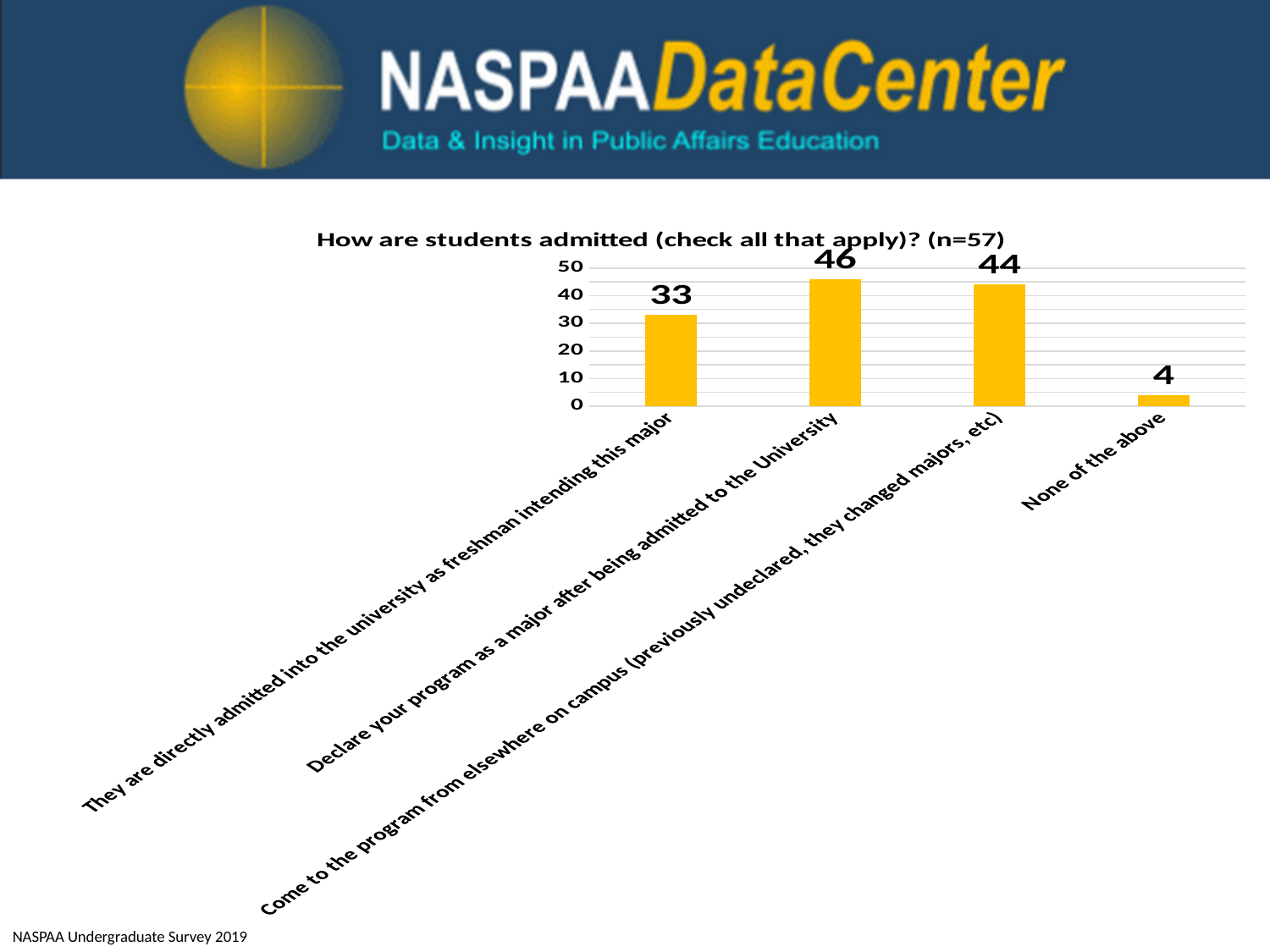
Which is larger: the value for 'They are directly admitted into the university as freshman intending this major' or the value for 'None of the above'? They are directly admitted into the university as freshman intending this major Which category has the highest value? Declare your program as a major after being admitted to the University What is the difference between the values for 'Declare your program as a major after being admitted to the University' and 'They are directly admitted into the university as freshman intending this major'? 13 What is the title of the chart? How are students admitted (check all that apply)? (n=57) What is the value for 'Come to the program from elsewhere on campus (previously undeclared, they changed majors, etc)'? 44 What is the value for 'Declare your program as a major after being admitted to the University'? 46 What is the value for 'They are directly admitted into the university as freshman intending this major'? 33 Is the value for 'Come to the program from elsewhere on campus (previously undeclared, they changed majors, etc)' greater or less than 40? greater What kind of chart is shown on the slide? bar chart Which category has the lowest value? None of the above What is the value for 'None of the above'? 4 How many categories are shown in the chart? 4